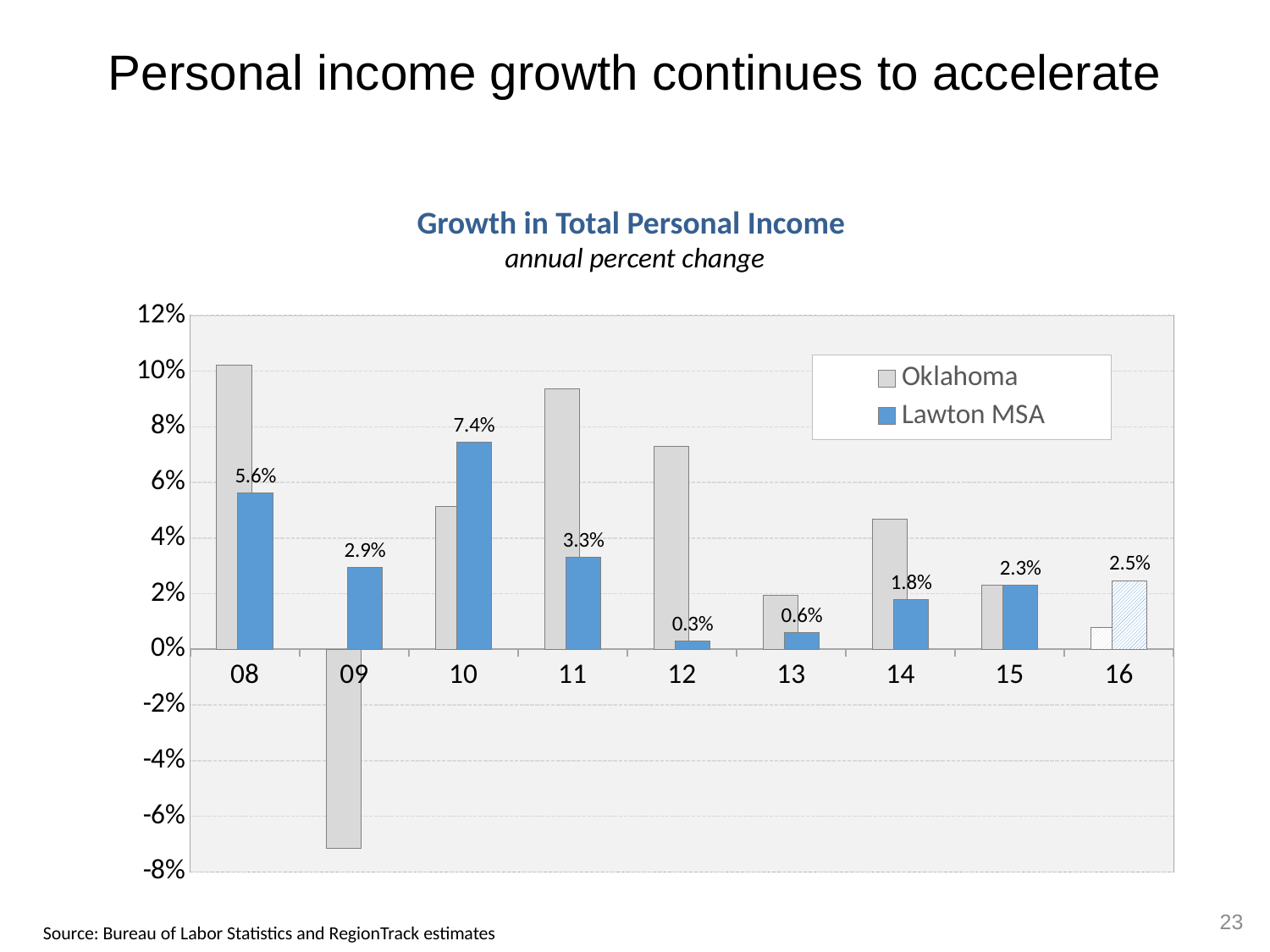
What kind of chart is shown? Bar chart What is the Lawton MSA value for 10? 7.4% What is the Lawton MSA value for 16? 2.5% In which year is the Lawton MSA value highest? 10 What is the difference between the Lawton MSA values for 08 and 09? 2.7% In which year is the Lawton MSA value lowest? 12 How many series does the legend list? 2 How many years are shown on the x axis? 9 What is the Lawton MSA value for 12? 0.3% Is the Oklahoma value for 08 greater or less than 8%? greater Is the Oklahoma value for 09 greater or less than -4%? less Which year has the larger Lawton MSA value, 14 or 15? 15